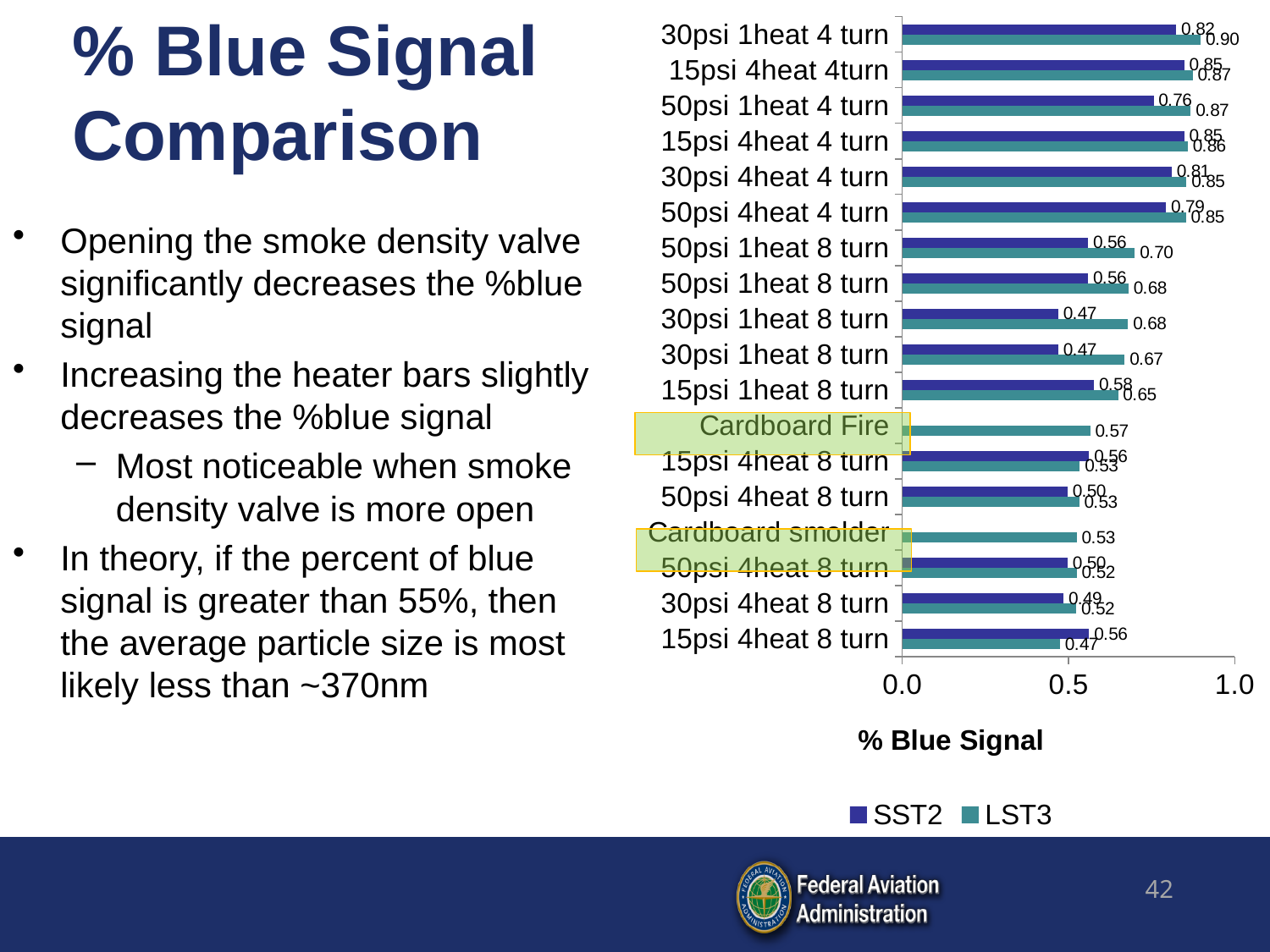
Is the LST3 value for Cardboard Fire greater or less than 0.5? greater How many series does the chart legend list? 2 What is the difference between the LST3 and SST2 values for 50psi 1heat 4 turn? 0.11 For 30psi 4heat 8 turn, which series has the larger value, SST2 or LST3? LST3 What is the SST2 value for 50psi 1heat 4 turn? 0.76 What type of chart is shown on the slide? bar chart What is the LST3 value for Cardboard Fire? 0.57 What is the LST3 value for Cardboard smolder? 0.53 How many categories are plotted on the chart? 18 What is the title of the x axis? % Blue Signal Which category has the highest LST3 value? 30psi 1heat 4 turn What is the LST3 value for 30psi 1heat 4 turn? 0.90